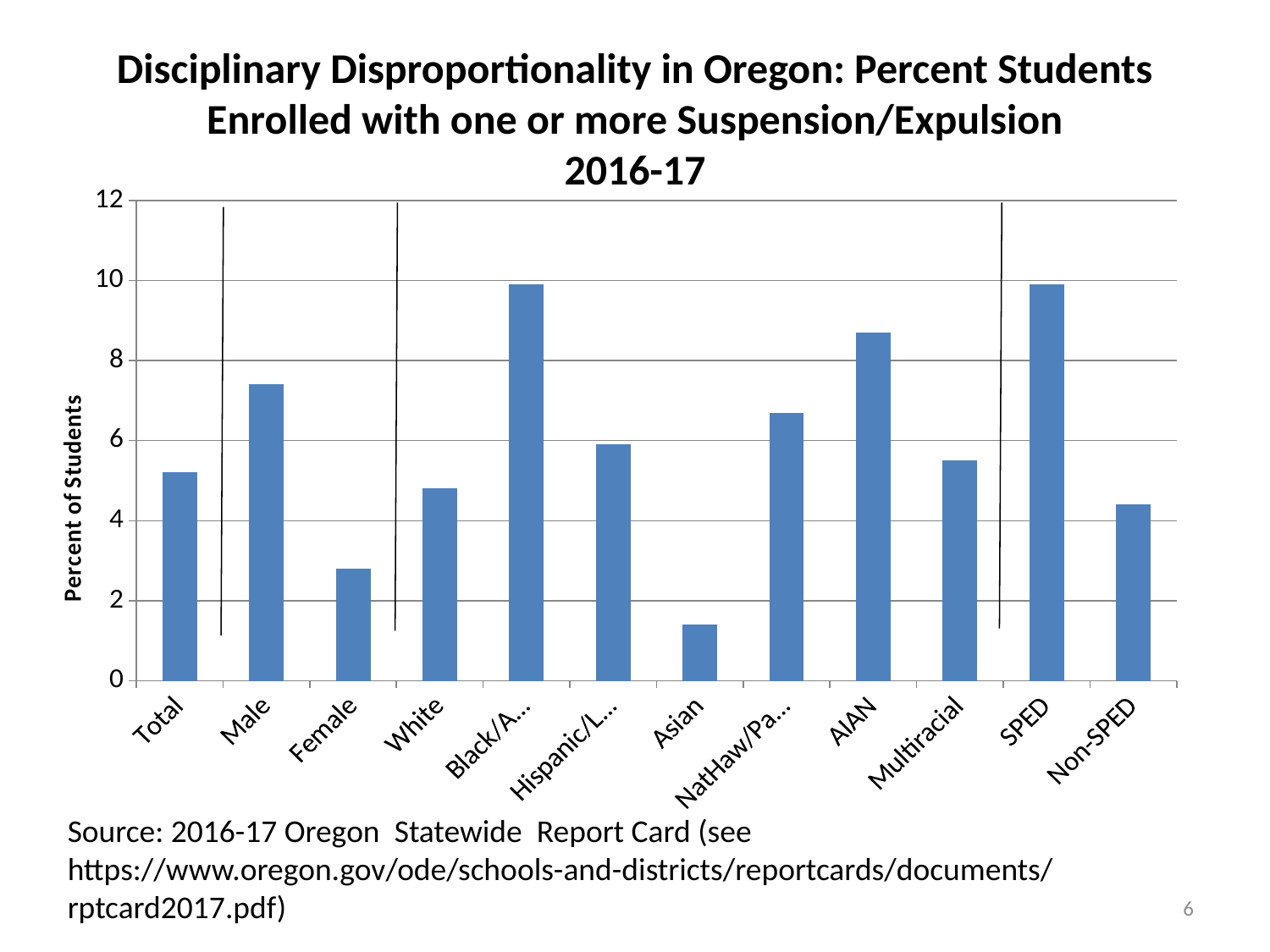
What is the label of the vertical axis? Percent of Students Which is larger, the value for SPED or the value for Non-SPED? SPED Is the value for Female greater or less than 4? less Is the value for Asian greater or less than 2? less Is the value for Total greater or less than 4? greater Which category has the lowest percent of students with one or more suspension/expulsion? Asian What kind of chart is shown on the slide? bar chart How many categories are plotted along the x axis? 12 Which is larger, the value for Male or the value for Female? Male Which is larger, the value for AIAN or the value for Multiracial? AIAN